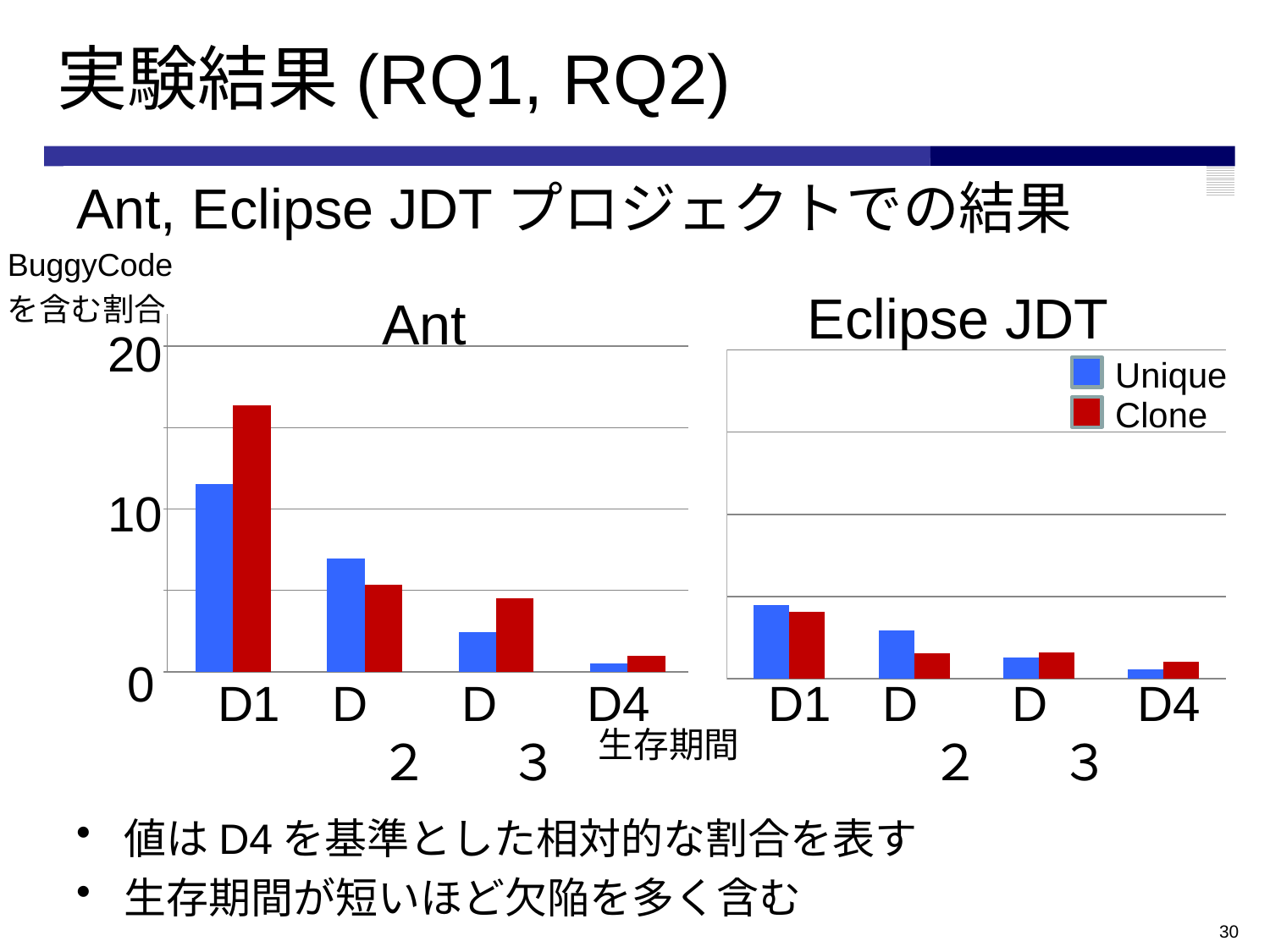
How many series does the legend list? 2 In the Ant chart, is the Clone value for D1 greater or less than 10? greater In the Ant chart, is the Unique value for D2 greater or less than 10? less What colour represents the Clone series in the legend? red How many categories are shown on the x axis of the Eclipse JDT chart? 4 In the Eclipse JDT chart, which category has the highest Unique value? D1 In the Ant chart, which category has the highest Clone value? D1 What kind of chart is the Ant chart? bar chart In the Ant chart, which category has the lowest Unique value? D4 In the Eclipse JDT chart, do the Unique values rise or fall from D1 to D4? fall In the Ant chart, which is larger for D1, Unique or Clone? Clone In the Ant chart, which is larger for D2, Unique or Clone? Unique